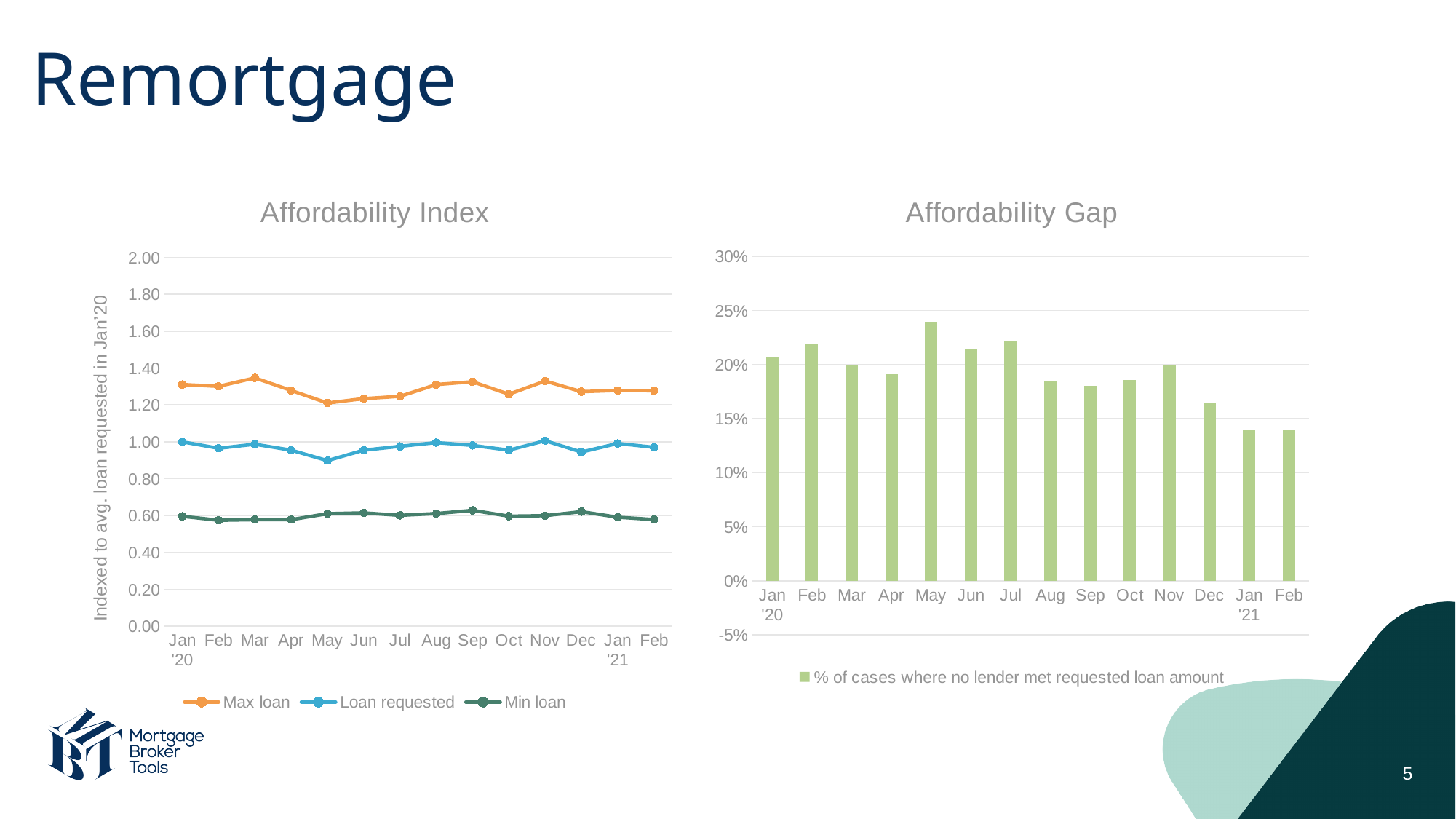
On the Affordability Index chart, is the Loan requested value for May greater or less than 1.00? less On the Affordability Gap chart, is the value for Jan '21 greater or less than 15%? less On the Affordability Gap chart, which month has the highest value? May On the Affordability Index chart, in which month is the Max loan series at its lowest? May On the Affordability Gap chart, is the value for Dec greater or less than 20%? less On the Affordability Gap chart, do the values overall rise or fall from Jan '20 to Feb '21? fall What kind of chart is the Affordability Gap chart? bar chart On the Affordability Index chart, how many series does the legend list? 3 On the Affordability Gap chart, how many months are plotted? 14 On the Affordability Index chart, which series is plotted in orange? Max loan What kind of chart is the Affordability Index chart? line chart